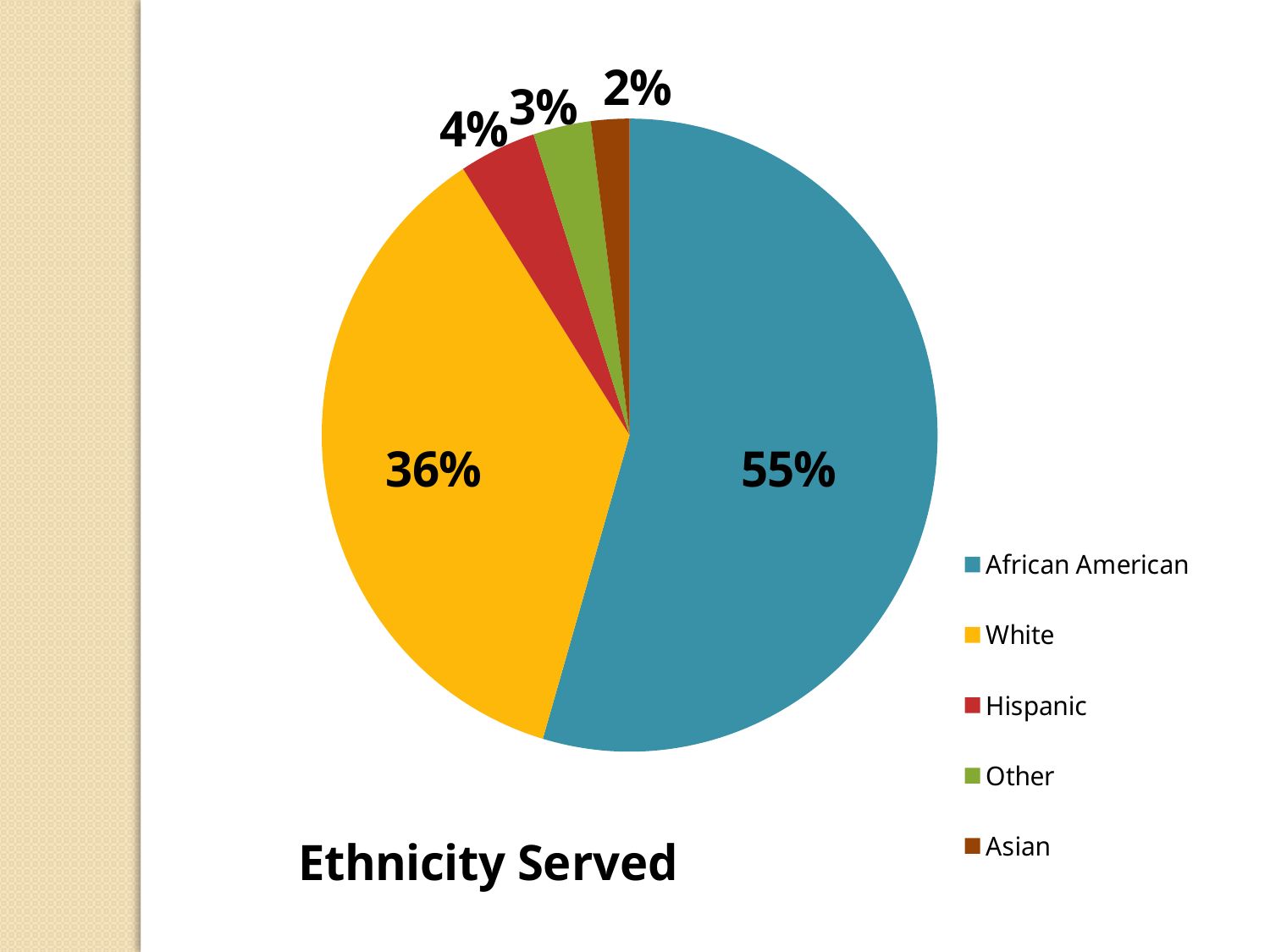
What percentage of the pie chart is Hispanic? 4% Which is larger, the share for Hispanic or the share for Other? Hispanic What percentage of the pie chart is African American? 55% How many categories does the legend list? 5 Which category has the smallest share of the pie? Asian What is the title of the chart? Ethnicity Served What percentage of the pie chart is White? 36% What percentage of the pie chart is Other? 3% What percentage of the pie chart is Asian? 2% What kind of chart is shown on the slide? Pie chart What is the difference in percentage points between African American and White? 19 Which category has the largest share of the pie? African American